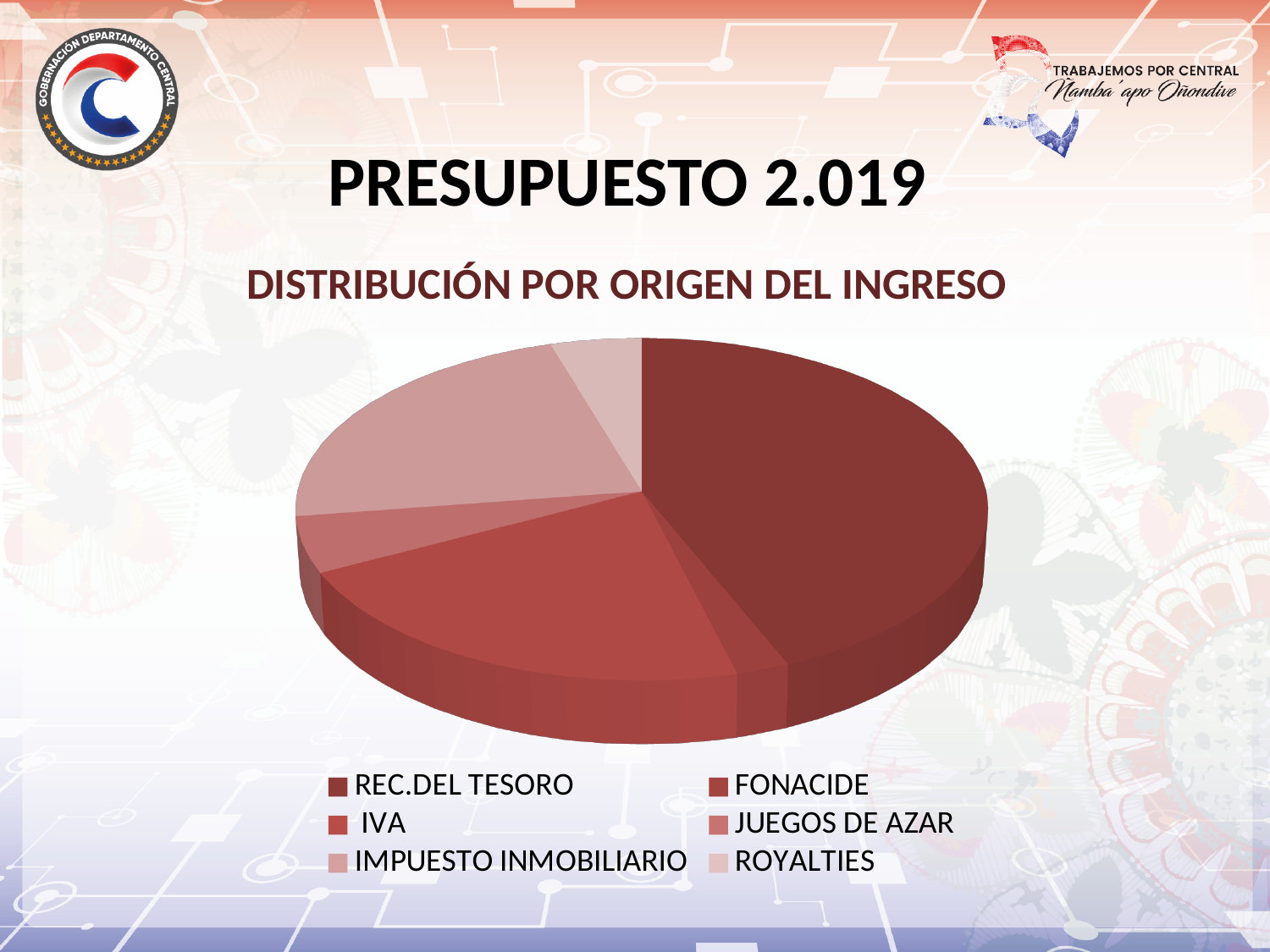
Which is larger, the slice for REC.DEL TESORO or the slice for ROYALTIES? REC.DEL TESORO What kind of chart is shown on the slide? pie chart Which is larger, the slice for REC.DEL TESORO or the slice for IVA? REC.DEL TESORO How many entries does the chart legend list? 6 Which legend entry is listed first? REC.DEL TESORO What is the title of the chart? DISTRIBUCIÓN POR ORIGEN DEL INGRESO Which category has the largest slice of the pie? REC.DEL TESORO Which is larger, the slice for REC.DEL TESORO or the slice for FONACIDE? REC.DEL TESORO